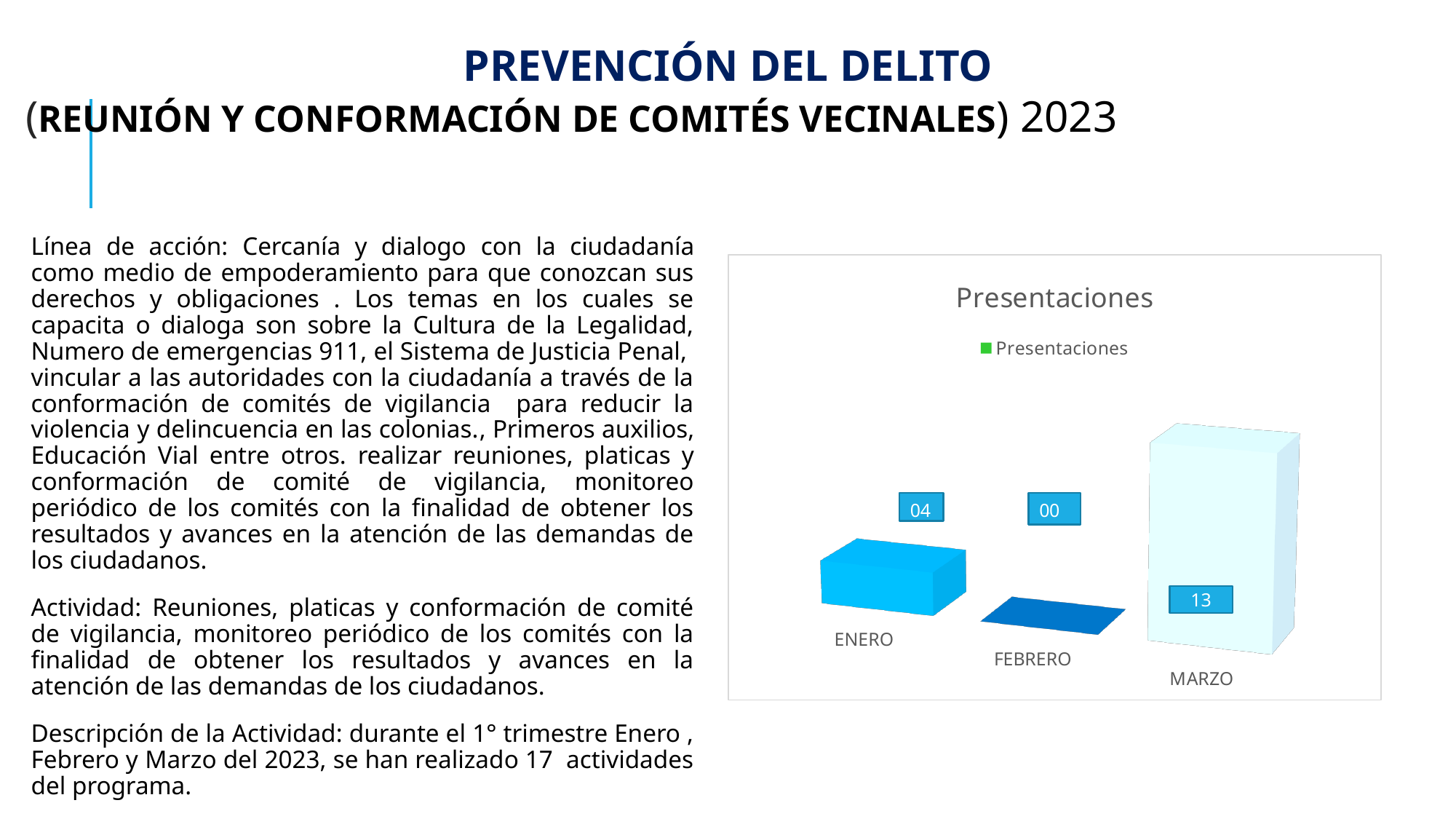
What is the title of the chart on the slide? Presentaciones What is the value for ENERO in the Presentaciones chart? 04 Which month has the highest value in the Presentaciones chart? MARZO Which is larger in the Presentaciones chart, the value for ENERO or the value for FEBRERO? ENERO What is the name of the series listed in the legend of the chart? Presentaciones Which month has the lowest value in the Presentaciones chart? FEBRERO How many series does the legend of the Presentaciones chart list? 1 What is the difference between the values for MARZO and ENERO in the Presentaciones chart? 9 What is the value for MARZO in the Presentaciones chart? 13 What kind of chart is the Presentaciones chart? bar chart What is the value for FEBRERO in the Presentaciones chart? 00 How many categories are shown in the Presentaciones chart? 3